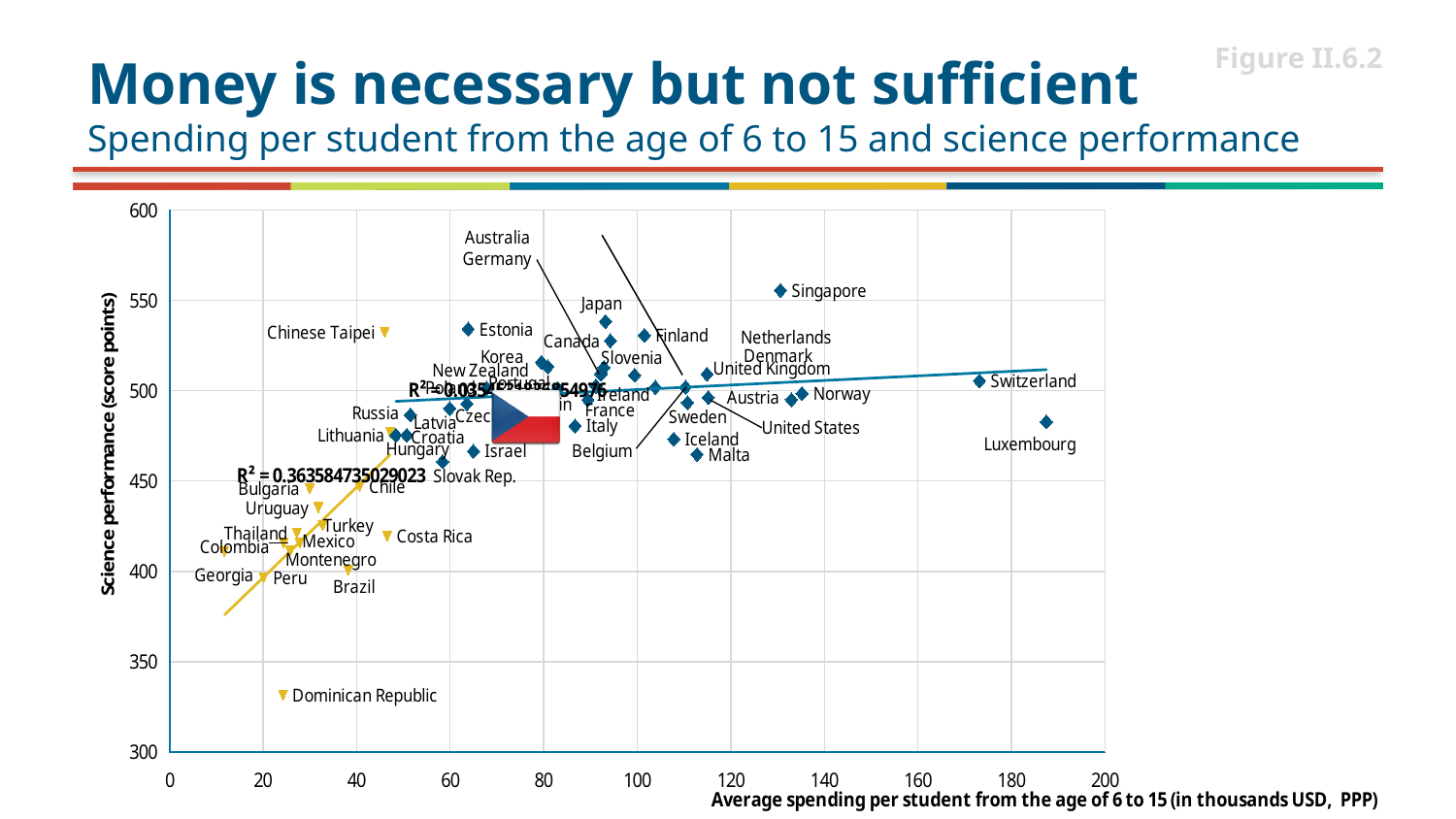
What kind of chart is shown on the slide? scatter chart Which country has the highest average spending per student on the chart? Luxembourg What is the label of the vertical axis? Science performance (score points) Which country has the lowest science performance on the chart? Dominican Republic Which has the higher average spending per student, Luxembourg or Switzerland? Luxembourg Is the average spending per student for Luxembourg greater or less than 180? greater Is the science performance for Singapore greater or less than 500? greater Which country has the highest science performance on the chart? Singapore Is the science performance for the Dominican Republic greater or less than 350? less Which has the higher science performance, Singapore or Luxembourg? Singapore